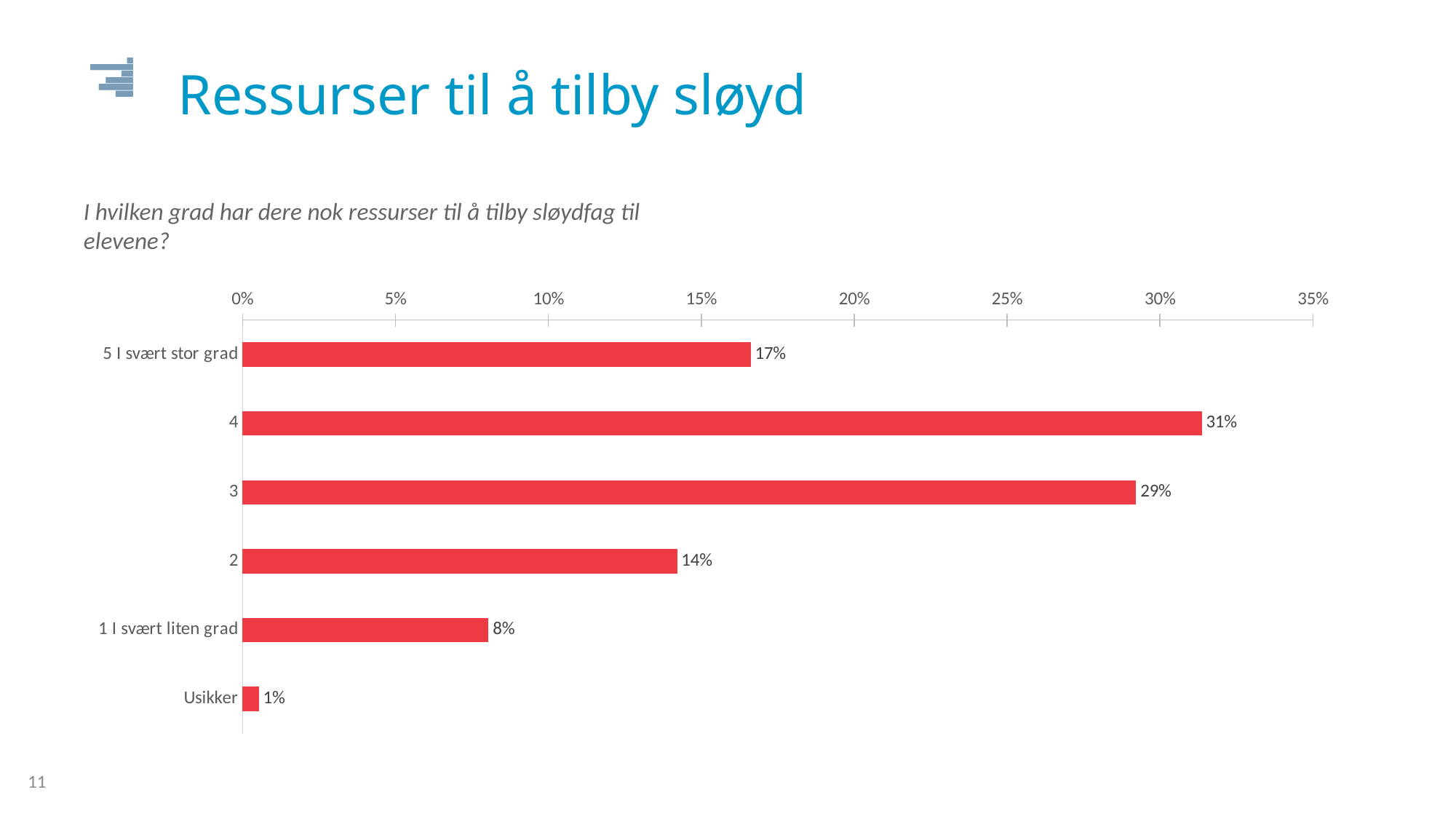
Which category has the highest value? 4 What kind of chart is shown on the slide? Bar chart How many categories are shown in the chart? 6 What is the value for the category "4"? 31% What is the value for "Usikker"? 1% What is the difference between the values for "5 I svært stor grad" and "2"? 3% What is the difference between the values for "4" and "3"? 2% Which category has the lowest value? Usikker Which is larger, the value for "2" or the value for "1 I svært liten grad"? 2 What is the question text shown above the chart? I hvilken grad har dere nok ressurser til å tilby sløydfag til elevene? What percentage of respondents answered "5 I svært stor grad"? 17% What percentage is shown for "1 I svært liten grad"? 8%